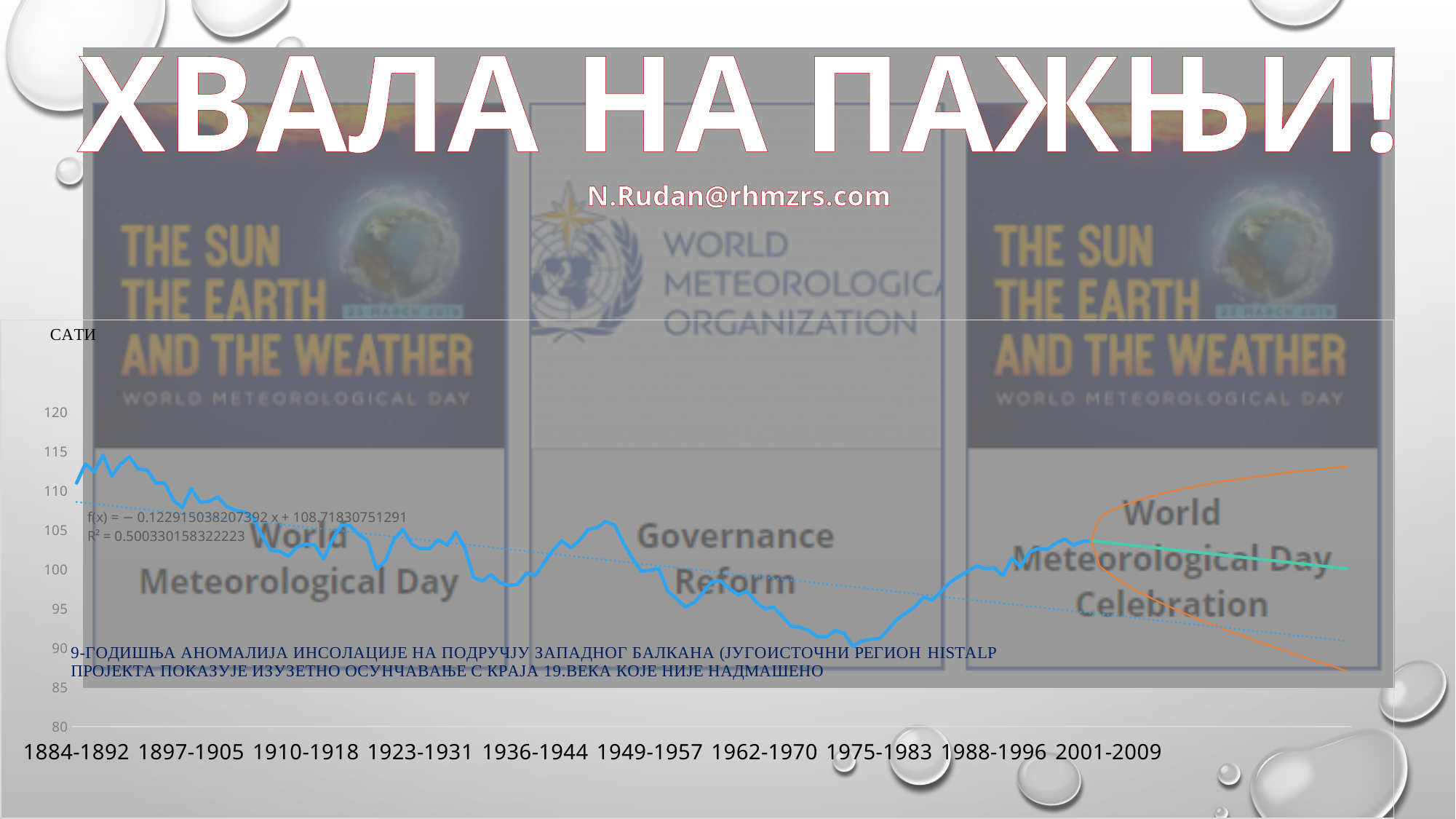
Does the dotted trend line in the chart rise or fall from left to right? fall Is the lowest point of the blue line greater or less than 95? less What is the highest tick value shown on the vertical axis? 120 Is the value of the blue line at the start of the 1884-1892 period greater or less than 110? greater What kind of chart is shown on the slide? line chart What is the title of the vertical axis of the chart? САТИ How many period labels are shown on the horizontal axis of the chart? 10 What is the first period label on the horizontal axis? 1884-1892 What is the last period label on the horizontal axis? 2001-2009 Is the value of the blue line at the end of the 2001-2009 period greater or less than 100? greater Is the blue line higher at 1884-1892 or at 2001-2009? 1884-1892 What R² value is printed on the chart? R² = 0.500330158322223